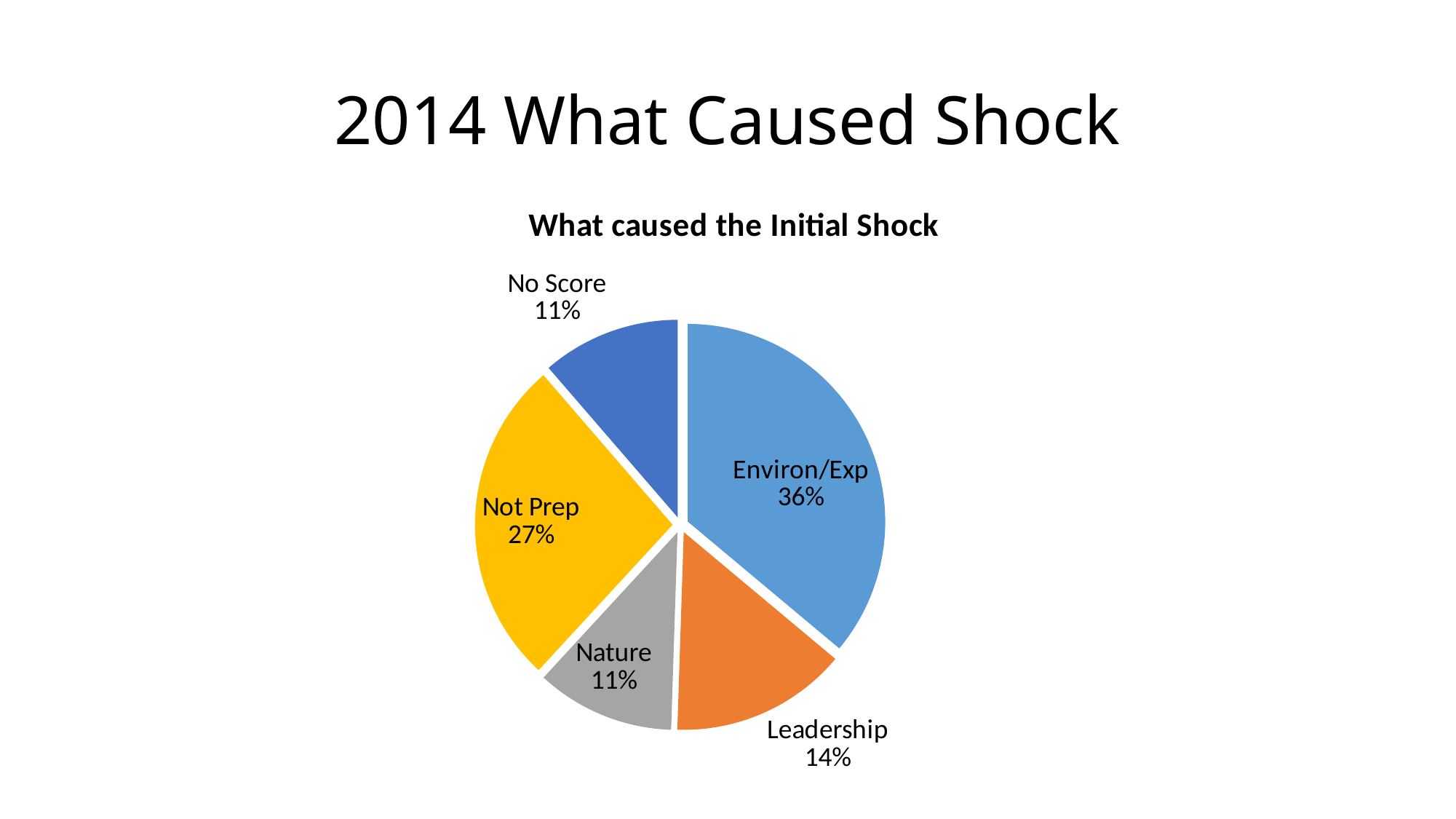
What percentage is shown for Not Prep? 27% What percentage is shown for Nature? 11% What is the difference in percentage points between Environ/Exp and Not Prep? 9 Which is larger, the share for Leadership or the share for Nature? Leadership How many slices does the pie chart have? 5 Which category has the largest slice of the pie? Environ/Exp Which colour is the Not Prep slice? yellow What is the difference in percentage points between Not Prep and Leadership? 13 What percentage is shown for Leadership? 14% What is the chart's title? What caused the Initial Shock What share of the pie does Environ/Exp account for? 36% What type of chart is shown on the slide? pie chart